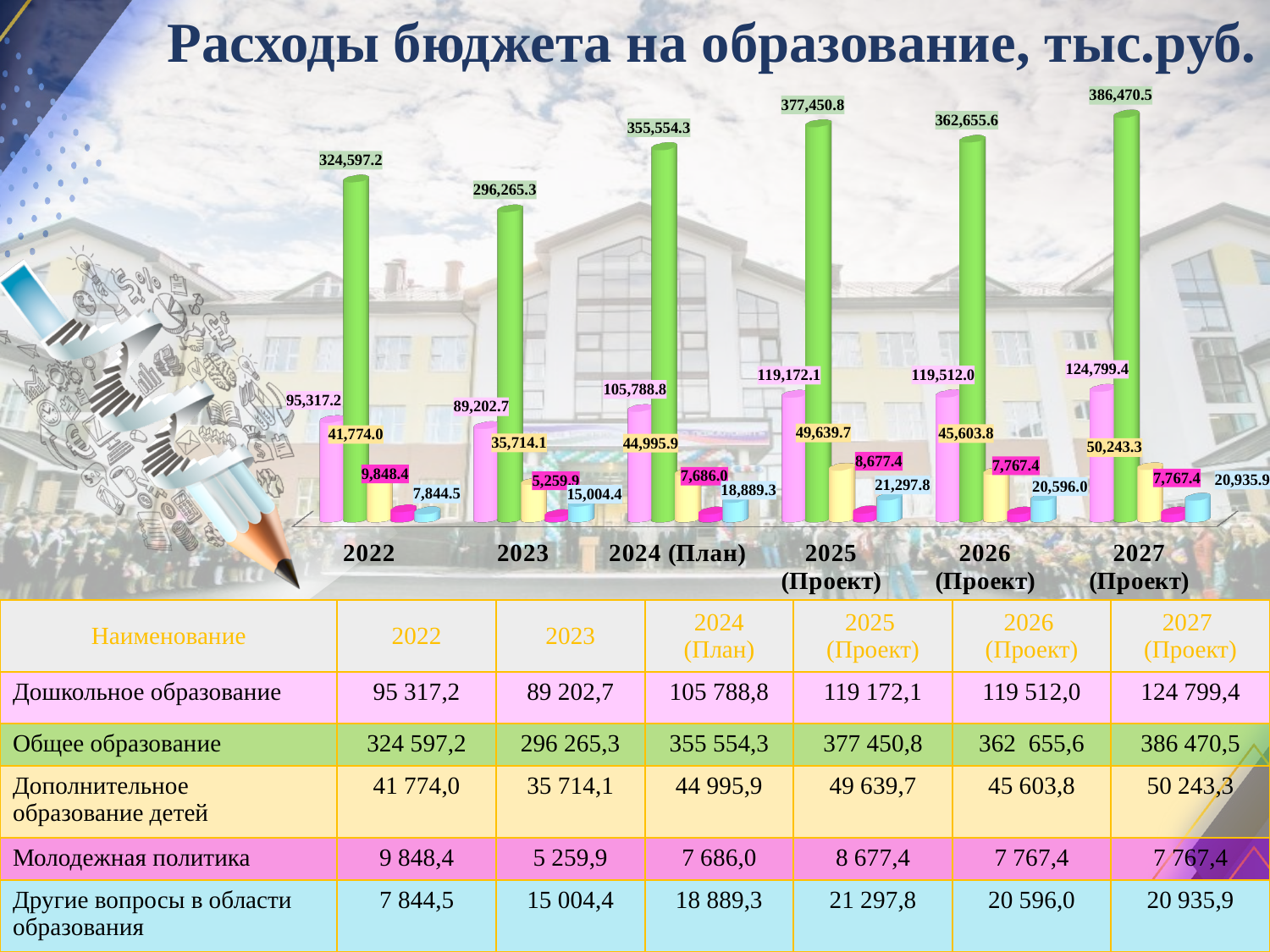
What is the difference between the yellow bar (Дополнительное образование детей) values for 2025 (Проект) and 2024 (План)? 4,643.8 How many years (categories) are shown along the x axis of the chart? 6 In which year is the green bar (Общее образование) the highest? 2027 (Проект) What is the value of the light blue bar (Другие вопросы в области образования) for 2022? 7,844.5 What is the title of the chart? Расходы бюджета на образование, тыс.руб. What kind of chart is shown on the slide? bar chart Which is larger, the pink bar (Дошкольное образование) for 2022 or for 2023? 2022 In which year is the green bar (Общее образование) the lowest? 2023 How many bars are plotted for each year in the chart? 5 What is the value of the green bar (Общее образование) for 2022? 324,597.2 What is the difference between the green bar values for 2027 (Проект) and 2022? 61,873.3 What is the value of the magenta bar (Молодежная политика) for 2023? 5,259.9